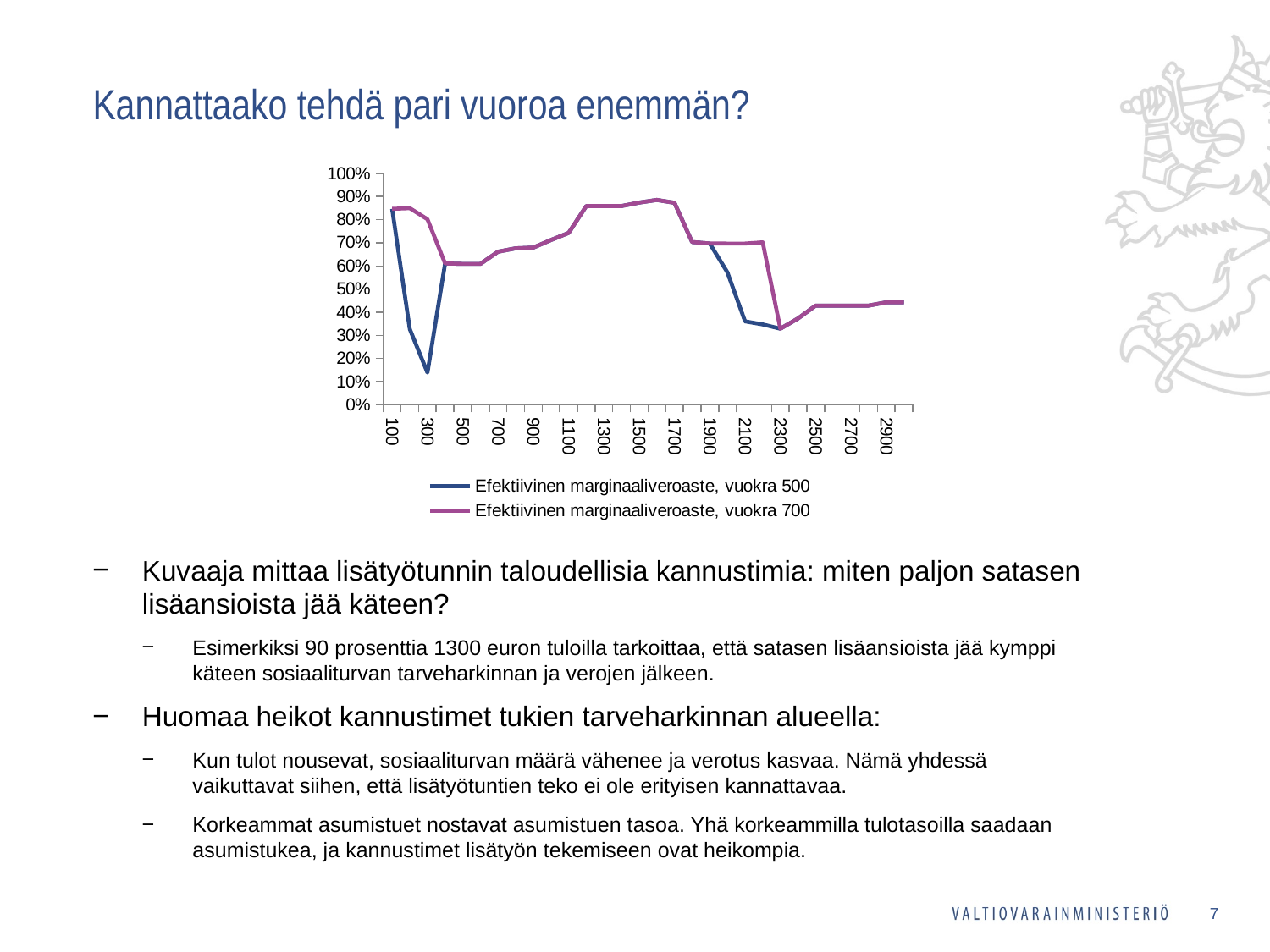
How many labelled tick values are shown on the x axis of the chart? 15 At which x-axis value does the 'vuokra 500' series reach its lowest point? 300 At 300 on the x axis, which series has the higher value, 'vuokra 500' or 'vuokra 700'? vuokra 700 What are the two series named in the chart legend? Efektiivinen marginaaliveroaste, vuokra 500 and Efektiivinen marginaaliveroaste, vuokra 700 Is the value of the 'vuokra 500' series at 2100 greater or less than 50%? less What kind of chart is shown on the slide? line chart Is the value of the 'vuokra 700' series at 2100 greater or less than 60%? greater Is the value of the 'vuokra 700' series at 300 greater or less than 70%? greater Between 1100 and 1700 on the x axis, do the series values rise or fall? rise How many series does the chart legend list? 2